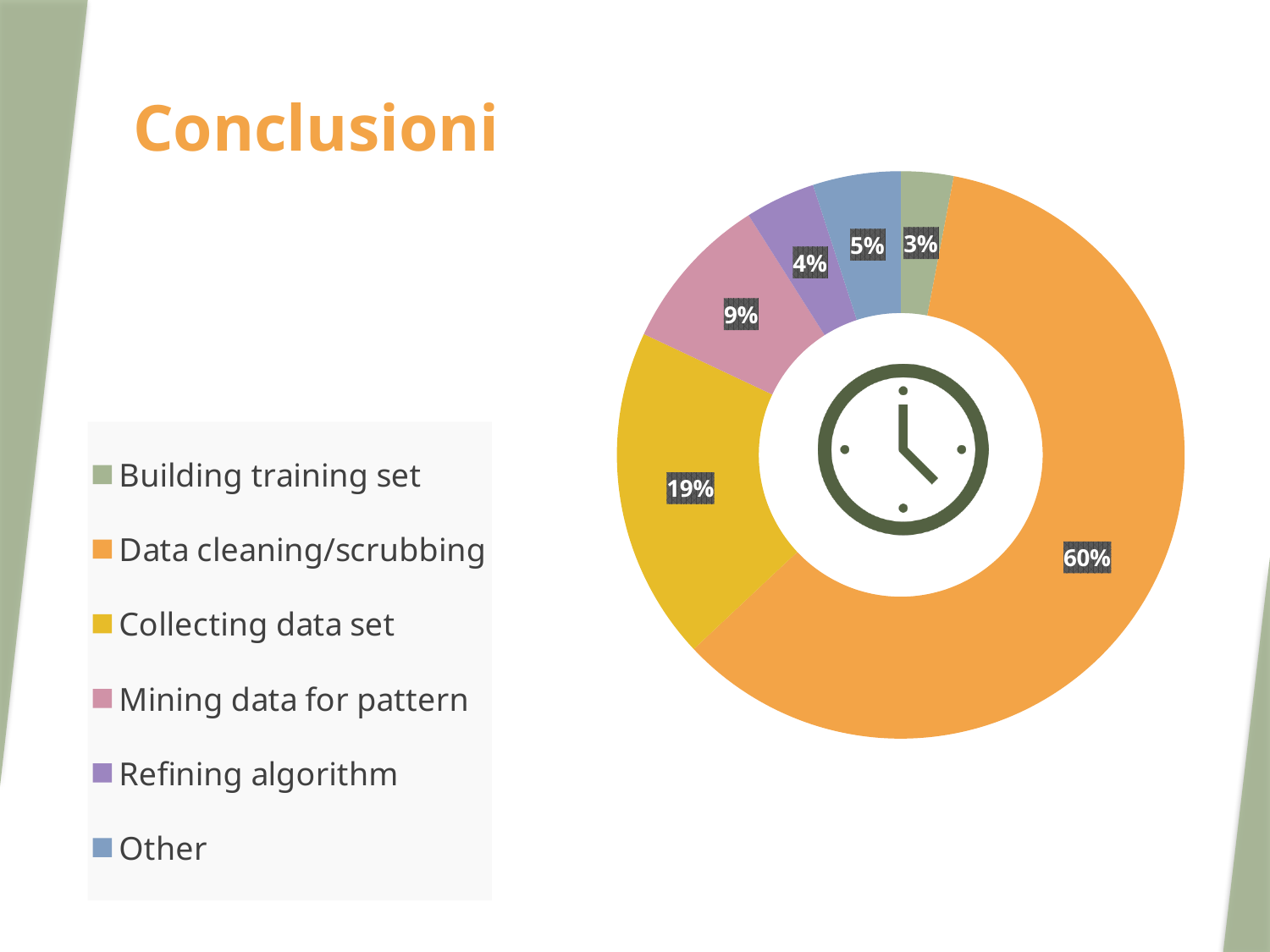
What percentage is shown for Refining algorithm? 4% What percentage is shown for Mining data for pattern? 9% What is the difference in percentage points between Data cleaning/scrubbing and Collecting data set? 41 What percentage is shown for Other? 5% Which is larger, the share for Mining data for pattern or the share for Other? Mining data for pattern What percentage is shown for Data cleaning/scrubbing? 60% What percentage is shown for Collecting data set? 19% Which category has the largest share of the chart? Data cleaning/scrubbing What kind of chart is shown on the slide? Doughnut (pie) chart How many categories does the legend list? 6 What percentage is shown for Building training set? 3% Which category has the smallest share of the chart? Building training set